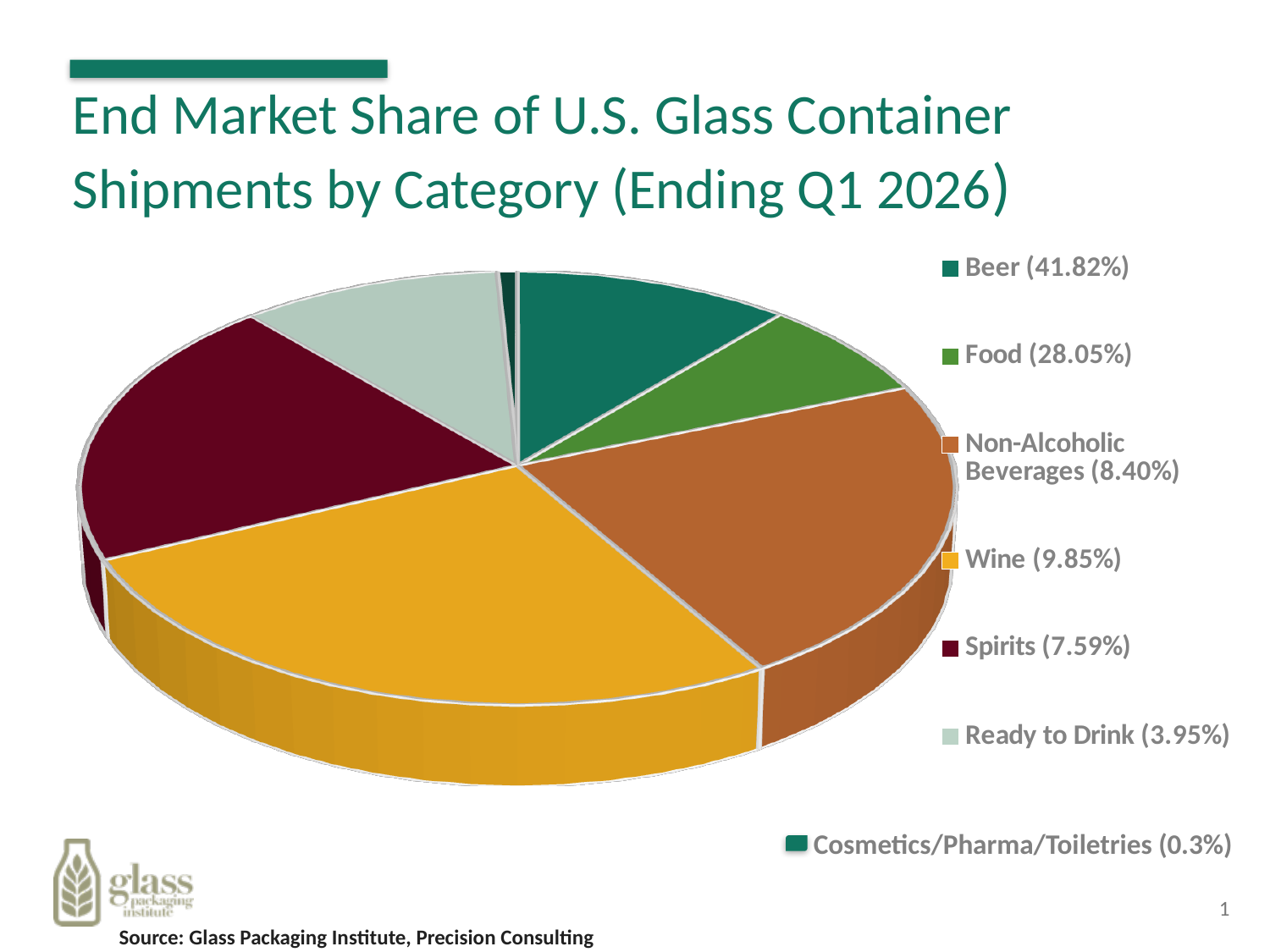
What percentage is shown for Food in the legend? 28.05% Which category has the smallest share according to the legend percentages? Cosmetics/Pharma/Toiletries What percentage is shown for Ready to Drink? 3.95% What share is listed for Non-Alcoholic Beverages? 8.40% What is the difference between the Beer share and the Food share as listed in the legend? 13.77% Which category has the largest share according to the legend percentages? Beer What share is listed for Cosmetics/Pharma/Toiletries? 0.3% How many categories are listed in the legend? 7 What kind of chart is shown on the slide? Pie chart What share is listed for Spirits? 7.59% What share of U.S. glass container shipments does Beer account for according to the legend? 41.82% What percentage is given for Wine? 9.85%